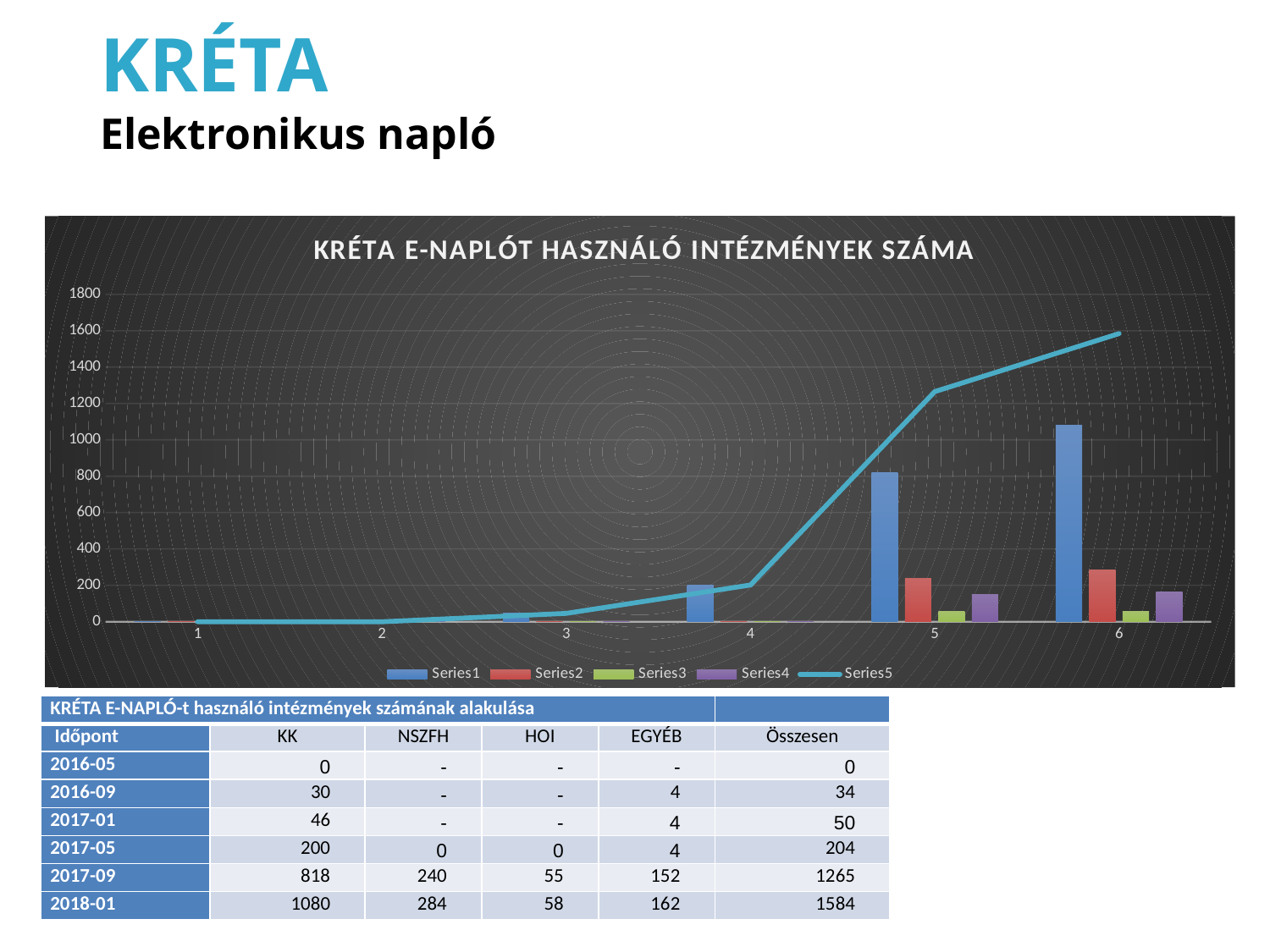
At which category does Series1 reach its highest value? 6 Is the value of Series5 at category 6 greater or less than 1400? greater How many series does the chart legend list? 5 What kind of chart is shown on the slide? Combined bar and line chart How many categories are shown on the x axis of the chart? 6 At category 6, which is larger: Series2 or Series4? Series2 Does the Series5 line rise or fall from category 1 to category 6? Rises What is the title of the chart? KRÉTA E-NAPLÓT HASZNÁLÓ INTÉZMÉNYEK SZÁMA Is the value of Series4 at category 6 greater or less than 200? less Is the value of Series1 at category 5 greater or less than 600? greater Which series is drawn as a line in the chart? Series5